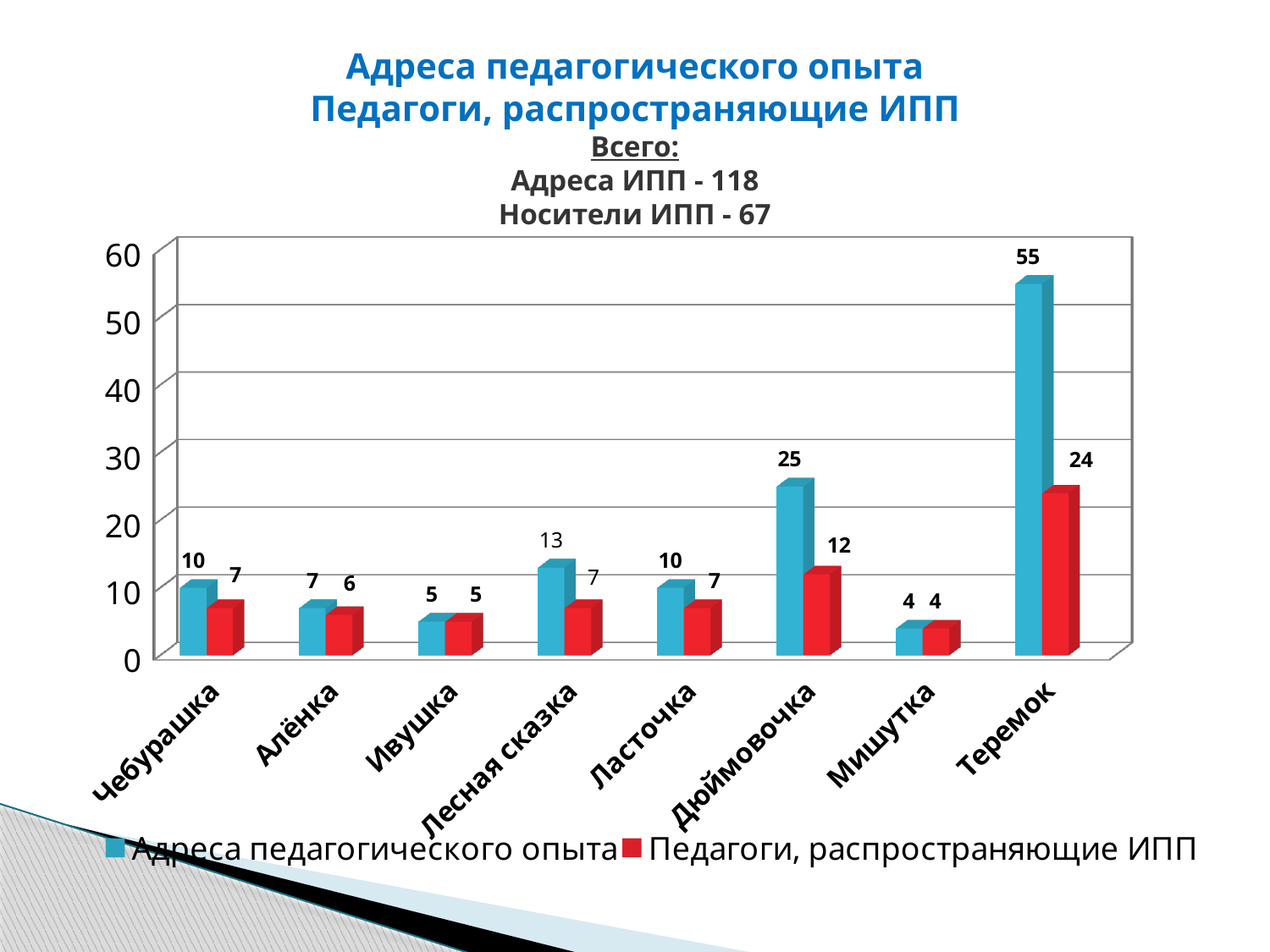
Which is larger: "Адреса педагогического опыта" for Дюймовочка or for Лесная сказка? Дюймовочка Which colour represents "Педагоги, распространяющие ИПП" in the legend? red Which category has the highest value for "Адреса педагогического опыта"? Теремок What is the value of "Адреса педагогического опыта" for Теремок? 55 What is the value of "Педагоги, распространяющие ИПП" for Дюймовочка? 12 What is the difference between "Адреса педагогического опыта" and "Педагоги, распространяющие ИПП" for Теремок? 31 What is the value of "Адреса педагогического опыта" for Лесная сказка? 13 Which category has the lowest value for "Педагоги, распространяющие ИПП"? Мишутка Is the value of "Адреса педагогического опыта" for Теремок greater or less than 50? greater How many series does the legend list? 2 What kind of chart is shown on the slide? bar chart How many categories are shown on the x axis? 8